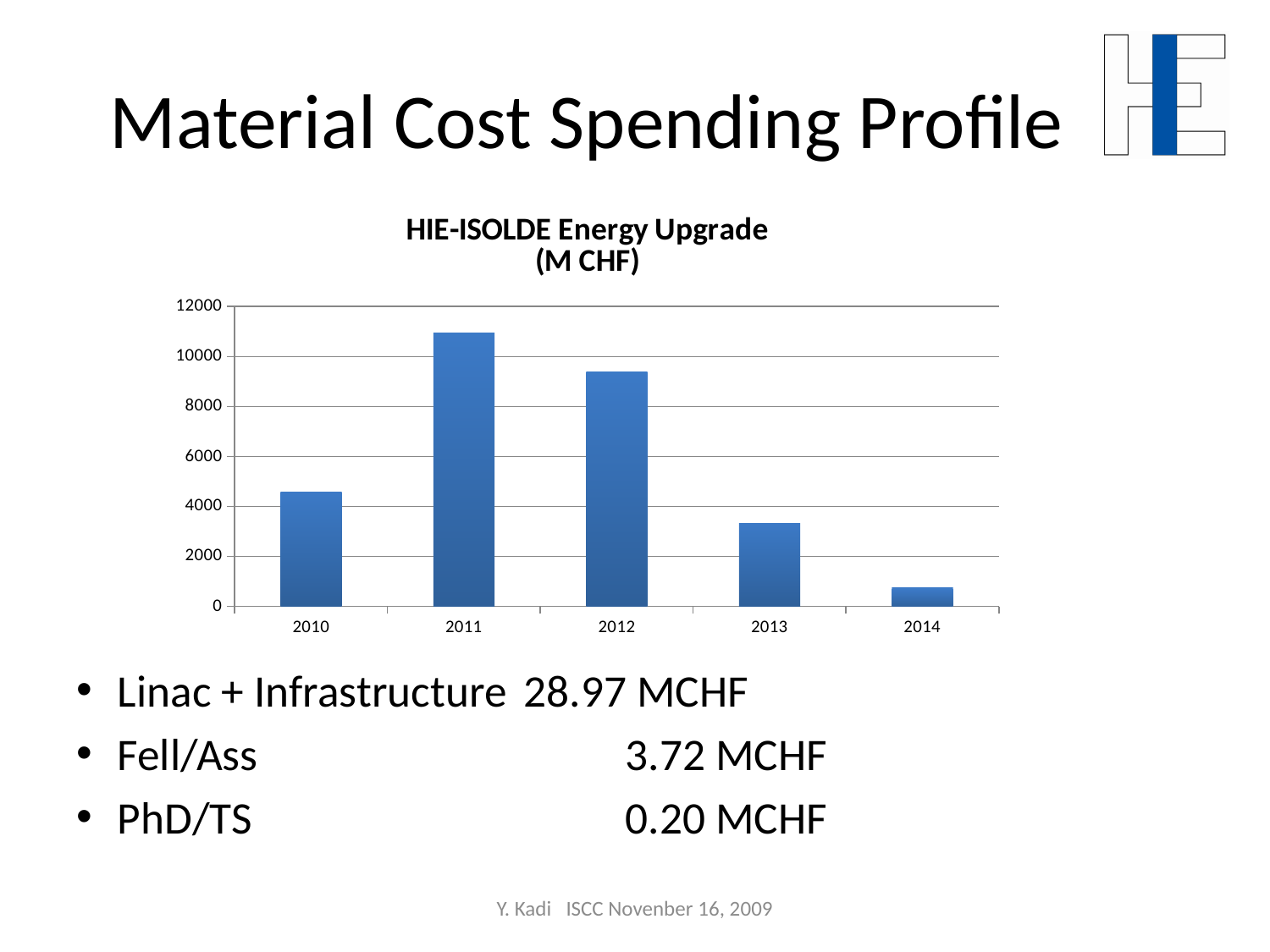
How many years are shown on the x axis of the chart? 5 Is the value for 2013 greater or less than 4000? less What kind of chart is shown on the slide? bar chart Is the value for 2010 greater or less than 4000? greater Which year has the highest bar in the chart? 2011 Is the value for 2014 greater or less than 2000? less Which year has the lowest bar in the chart? 2014 Which is larger, the value for 2012 or the value for 2013? 2012 What is the title of the chart? HIE-ISOLDE Energy Upgrade (M CHF) Do the values rise or fall from 2011 to 2014? fall